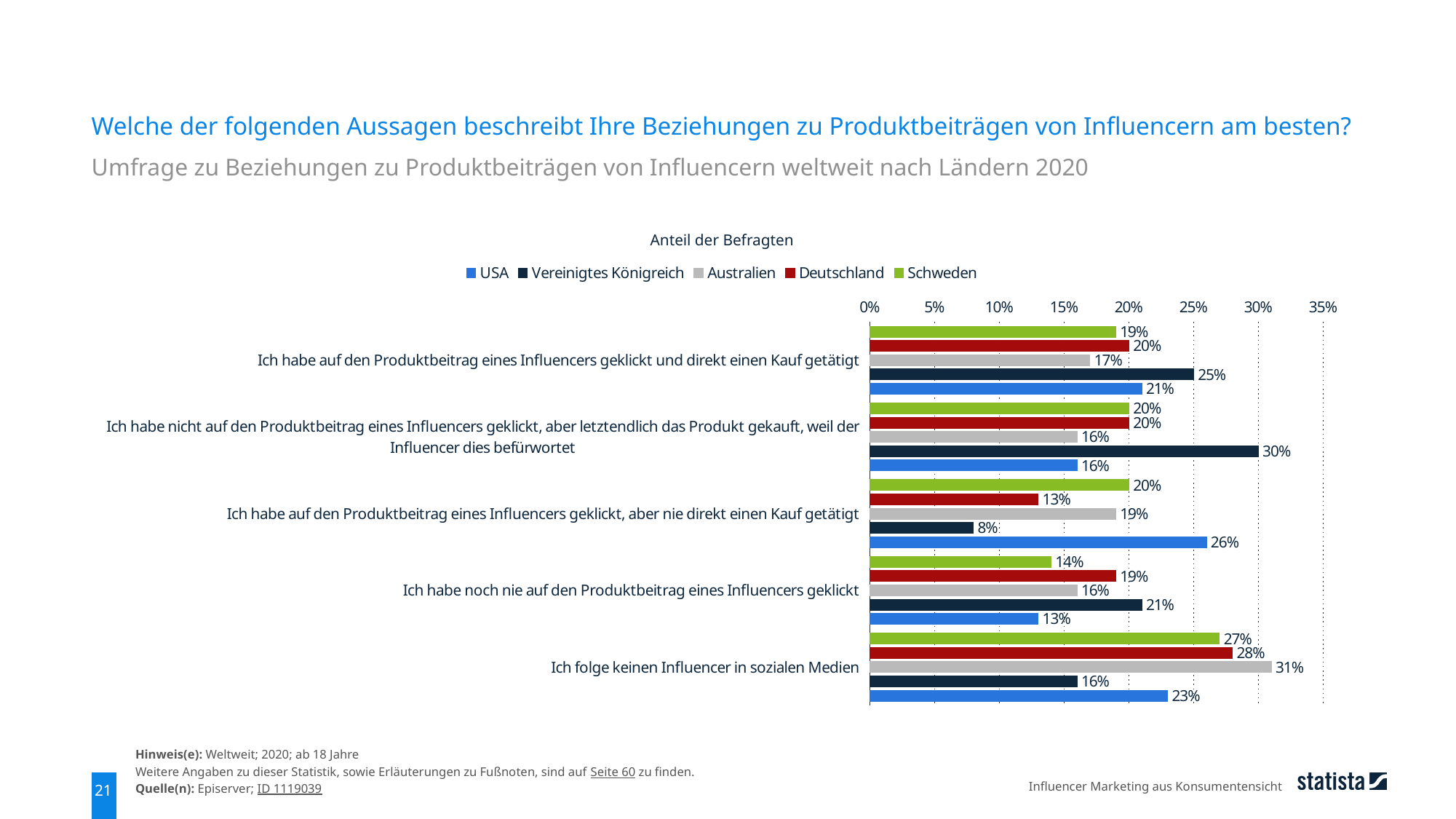
What is the value for Deutschland for "Ich habe noch nie auf den Produktbeitrag eines Influencers geklickt"? 19% How many series does the legend list? 5 What is the value for Australien for "Ich folge keinen Influencer in sozialen Medien"? 31% Which colour represents Schweden in the chart? Green What is the value for USA for "Ich habe auf den Produktbeitrag eines Influencers geklickt, aber nie direkt einen Kauf getätigt"? 26% How many statement categories are shown on the chart? 5 What kind of chart is shown on the slide? Bar chart Which country has the lowest value for "Ich habe auf den Produktbeitrag eines Influencers geklickt, aber nie direkt einen Kauf getätigt"? Vereinigtes Königreich What is the value for Vereinigtes Königreich for "Ich habe auf den Produktbeitrag eines Influencers geklickt und direkt einen Kauf getätigt"? 25% Which country has the highest value for "Ich habe nicht auf den Produktbeitrag eines Influencers geklickt, aber letztendlich das Produkt gekauft, weil der Influencer dies befürwortet"? Vereinigtes Königreich For "Ich habe noch nie auf den Produktbeitrag eines Influencers geklickt", which is larger: the value for Vereinigtes Königreich or for USA? Vereinigtes Königreich What is the difference between the Australien and Vereinigtes Königreich values for "Ich folge keinen Influencer in sozialen Medien"? 15%